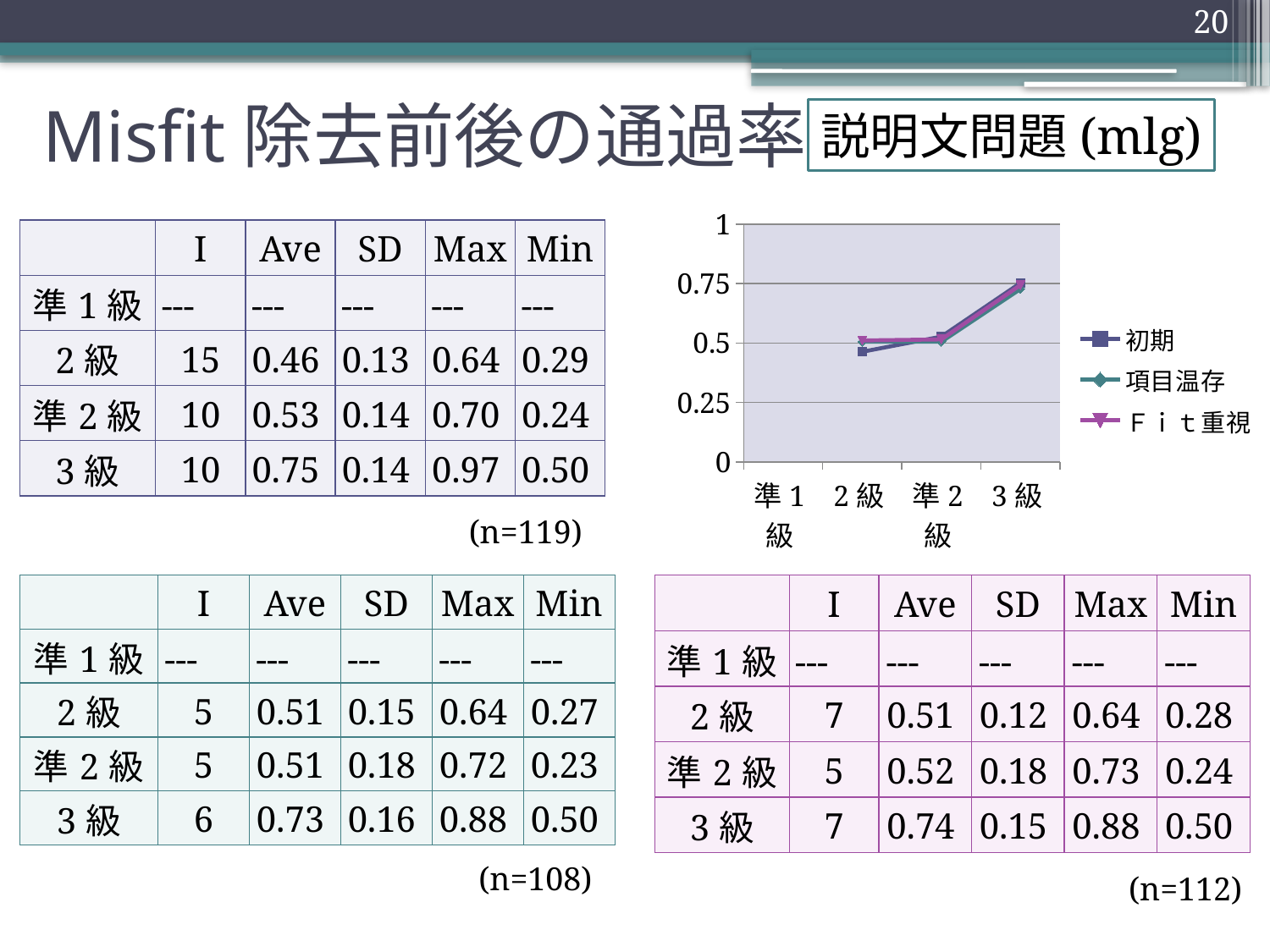
How many series does the chart's legend list? 3 What kind of chart is shown on the slide? line chart Is the value for Fit重視 at 準2級 greater or less than 0.25? greater Is the value for 項目温存 at 3級 greater or less than 1? less How many categories are labelled on the chart's x axis? 4 Is the value for 初期 at 3級 greater or less than 0.5? greater Which series is listed last in the chart's legend? Fit重視 Do the plotted values rise or fall from 2級 to 3級 along the x axis? rise Which series is listed first in the chart's legend? 初期